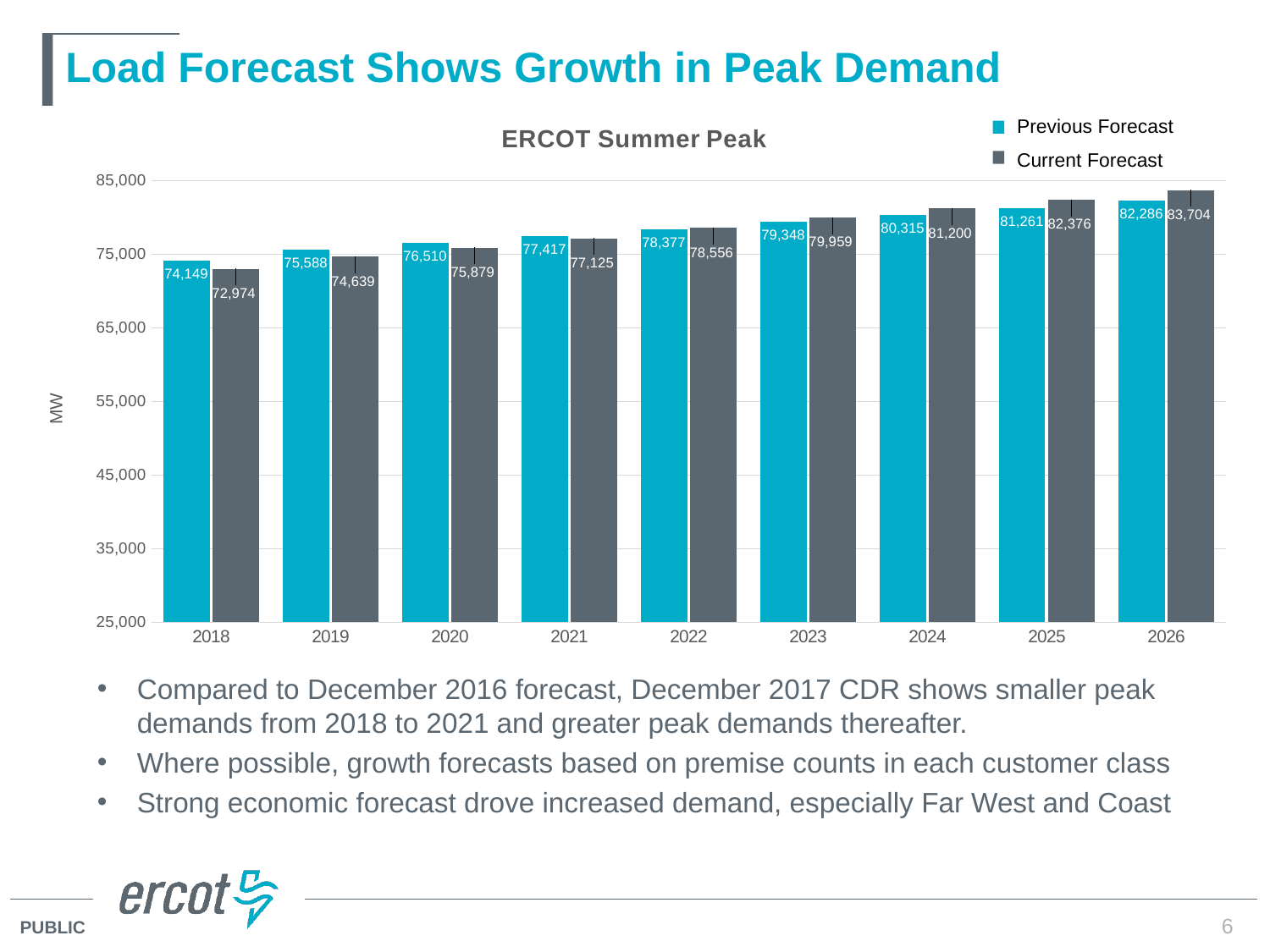
What is the difference between the Current Forecast and the Previous Forecast for 2026? 1,418 For 2020, which is larger: the Previous Forecast or the Current Forecast? Previous Forecast What is the Previous Forecast value for 2022? 78,377 Which year has the lowest Previous Forecast value? 2018 How many series does the legend list? 2 What is the difference between the Previous Forecast and the Current Forecast for 2018? 1,175 How many years are shown on the x axis of the chart? 9 What is the Current Forecast value for 2018 in the ERCOT Summer Peak chart? 72,974 For 2024, which is larger: the Previous Forecast or the Current Forecast? Current Forecast What type of chart is shown on the slide? Bar chart Which year has the highest Current Forecast value? 2026 What is the Current Forecast value for 2026? 83,704